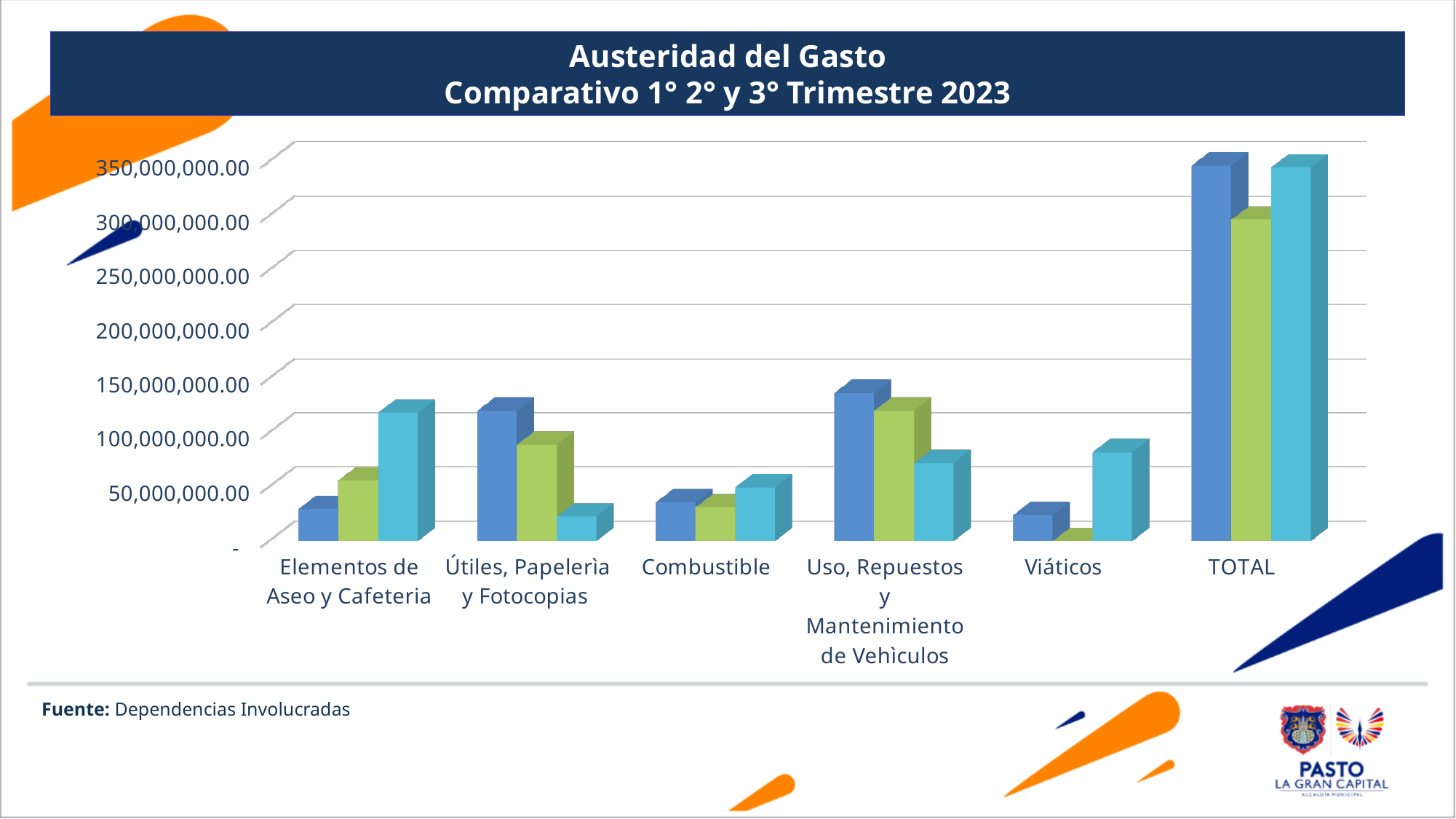
What kind of chart is shown on the slide? Bar chart Which category has the tallest bars in the chart? TOTAL Is the blue bar for TOTAL greater or less than 300,000,000.00? greater Is the blue bar for Combustible greater or less than 50,000,000.00? less Which is larger: the blue bar for Útiles, Papelería y Fotocopias or the blue bar for Combustible? Útiles, Papelería y Fotocopias Which category has the lowest green bar? Viáticos Is the light blue bar for Elementos de Aseo y Cafeteria greater or less than 100,000,000.00? greater How many categories are shown along the x axis of the chart? 6 How many bars are plotted for each category in the chart? 3 What is the title of the chart? Austeridad del Gasto Comparativo 1° 2° y 3° Trimestre 2023 Within the Útiles, Papelería y Fotocopias category, do the bars rise or fall from left to right? Fall Excluding TOTAL, which category has the tallest blue bar? Uso, Repuestos y Mantenimiento de Vehículos